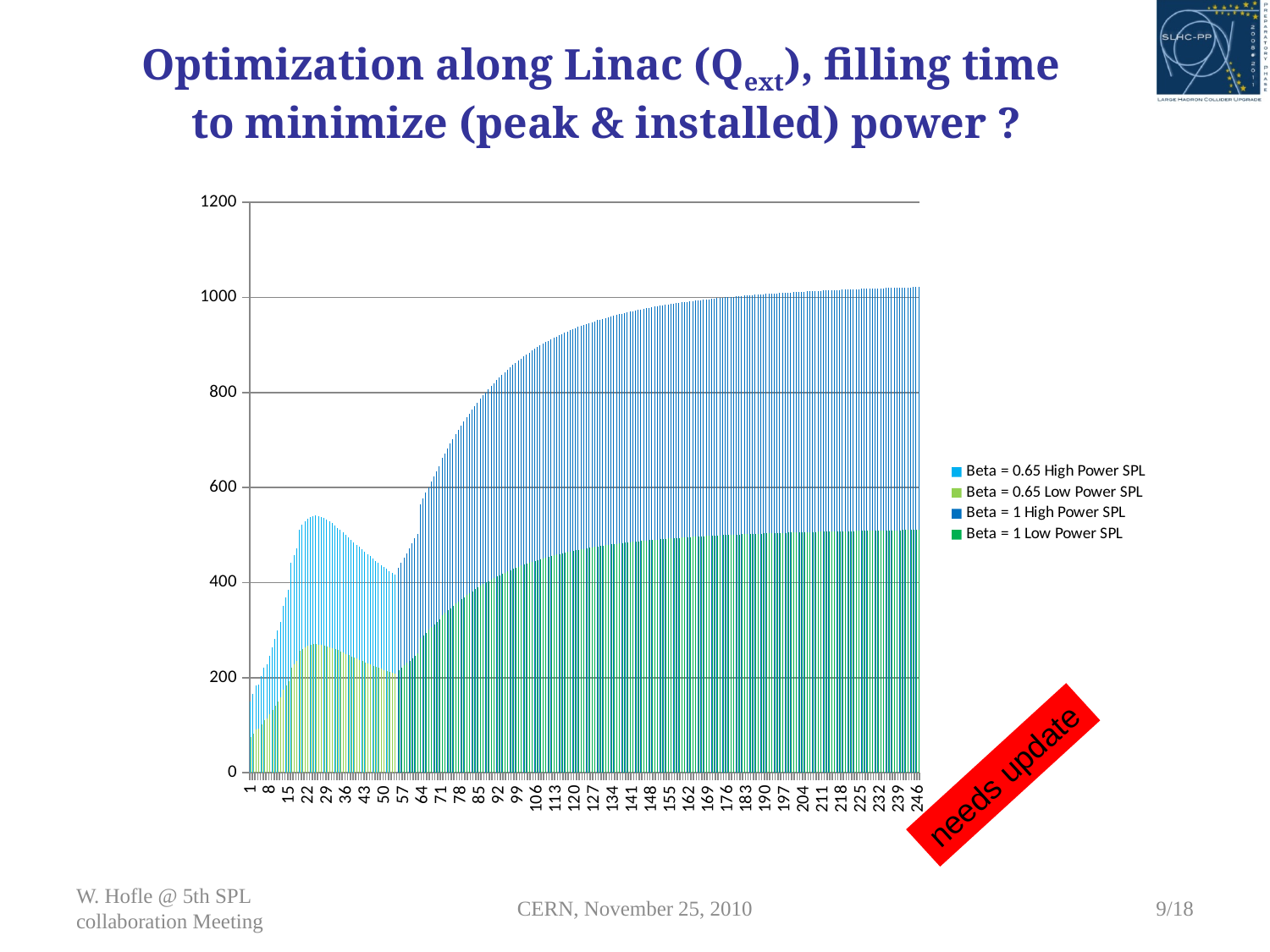
Do the values for Beta = 1 High Power SPL rise or fall along the x axis from category 64 to 246? rise At category 246, which is larger: Beta = 1 High Power SPL or Beta = 1 Low Power SPL? Beta = 1 High Power SPL Is the value for Beta = 0.65 Low Power SPL at category 22 greater or less than 200? greater What kind of chart is shown on the slide? bar chart What is the last legend entry listed? Beta = 1 Low Power SPL Is the value for Beta = 1 High Power SPL at category 246 greater or less than 800? greater What is the maximum value shown on the vertical axis? 1200 Is the value for Beta = 0.65 High Power SPL at category 1 greater or less than 400? less How many series does the legend list? 4 Which series reaches the highest value on the chart? Beta = 1 High Power SPL